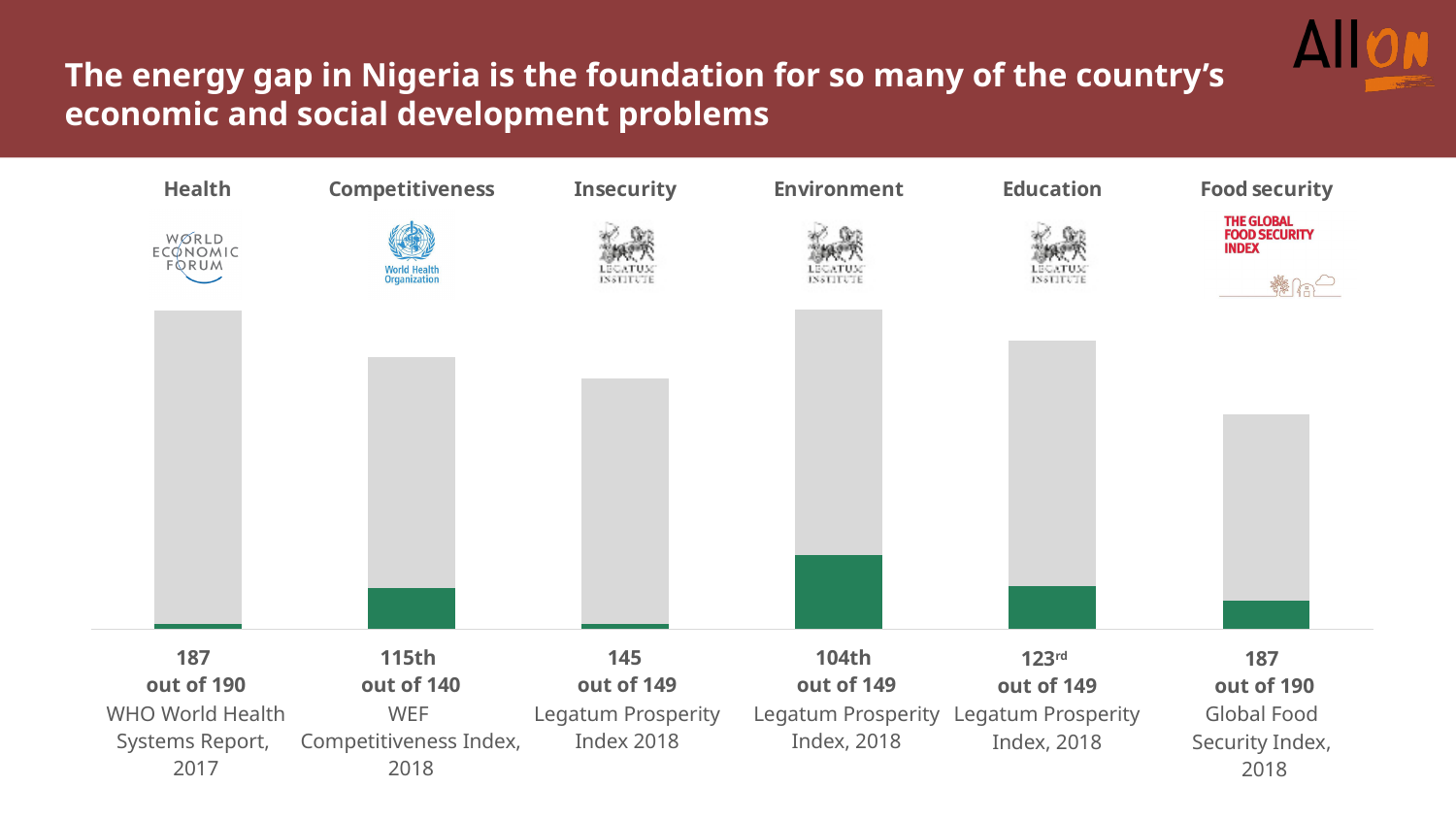
What is Nigeria's rank for Competitiveness? 115th out of 140 How many categories are shown on the chart? 6 What is Nigeria's rank for Education? 123rd out of 149 What is the difference between the Competitiveness rank (115th) and the Environment rank (104th)? 11 What is Nigeria's rank for Health on the chart? 187 out of 190 Which category has the best (lowest-numbered) rank for Nigeria? Environment Which rank number is larger, Health or Environment? Health What kind of chart is shown on the slide? Bar chart What is Nigeria's rank for Food security? 187 out of 190 What is Nigeria's rank for Insecurity? 145 out of 149 What is Nigeria's rank for Environment? 104th out of 149 Which source is cited for the Health ranking? WHO World Health Systems Report, 2017